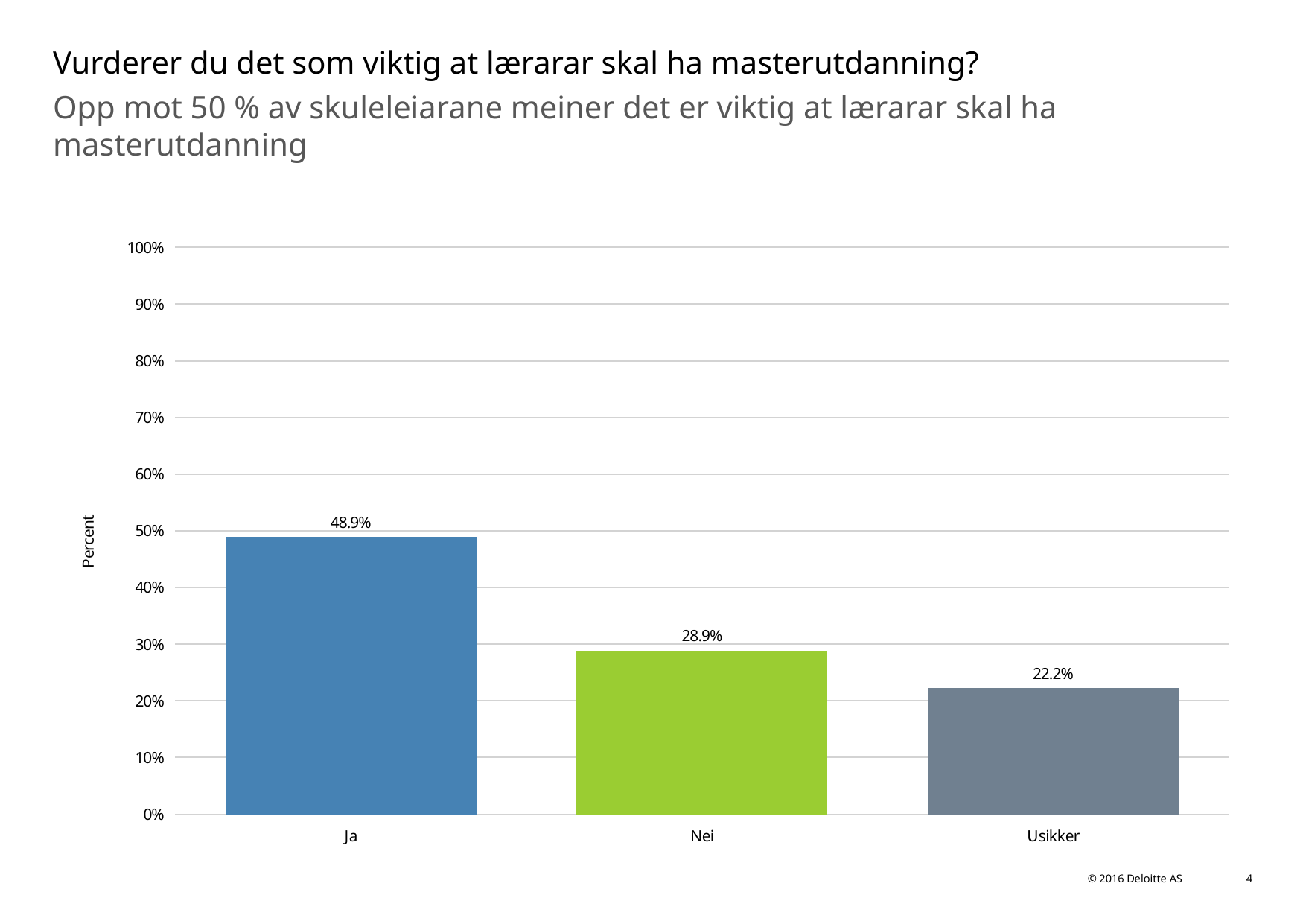
What is the value for Ja? 48.9% What is the difference between the values for Ja and Nei? 20 percentage points Is the value for Ja greater or less than 50%? less Which category has the lowest value? Usikker What kind of chart is shown on the slide? Bar chart Which is larger, the value for Nei or the value for Usikker? Nei What is the value for Usikker? 22.2% What is the value for Nei? 28.9% How many categories are shown on the x axis? 3 What is the difference between the values for Nei and Usikker? 6.7 percentage points What is the label of the y axis? Percent Which category has the highest value? Ja